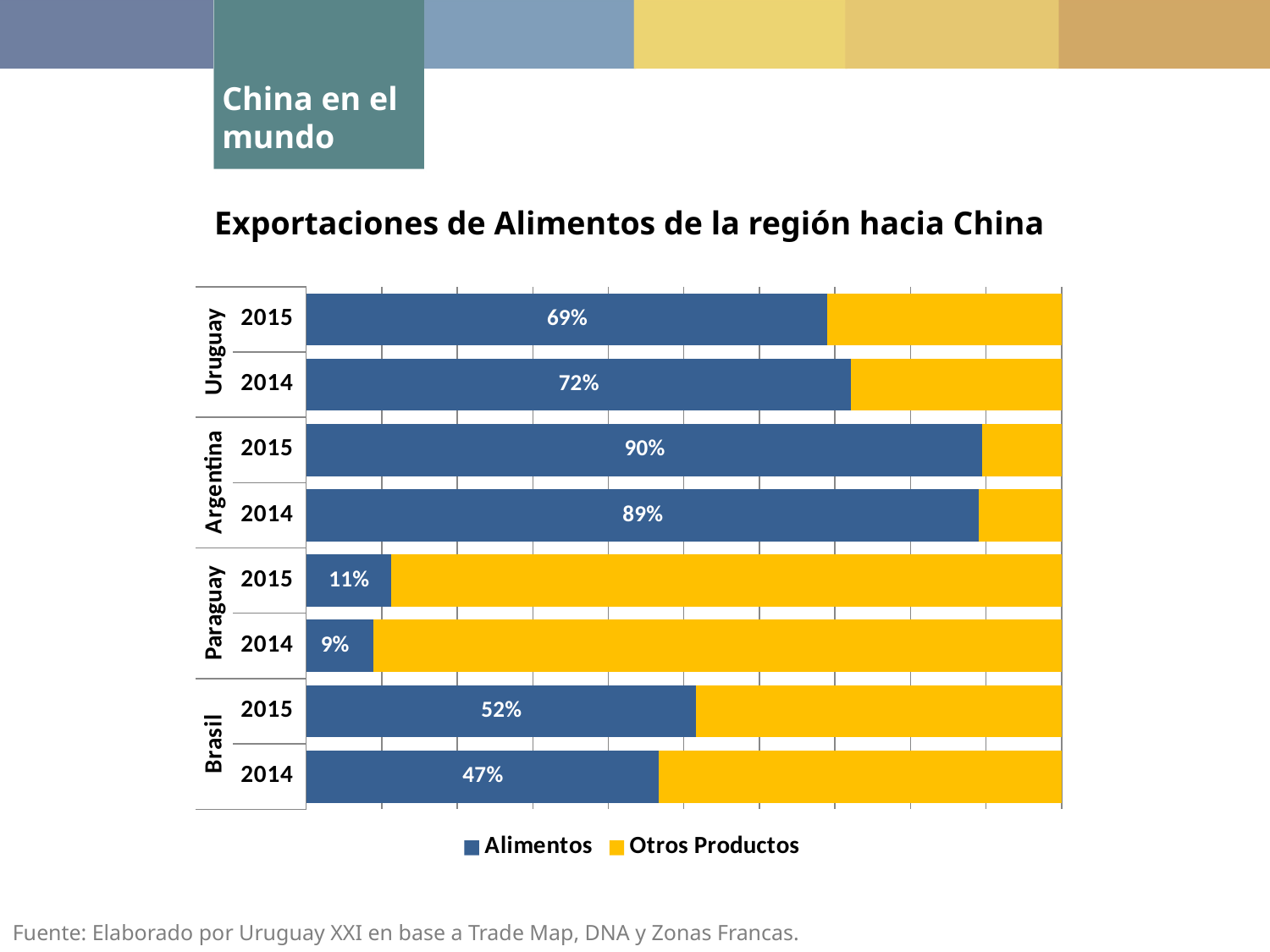
What is the Alimentos share for Paraguay in 2014? 9% Which country-year bar has the lowest Alimentos share? Paraguay 2014 Which is larger, the Alimentos share for Uruguay 2014 or for Brasil 2015? Uruguay 2014 Which country-year bar has the highest Alimentos share? Argentina 2015 What is the Alimentos share for Brasil in 2015? 52% What is the Alimentos share for Argentina in 2014? 89% What is the title of the chart? Exportaciones de Alimentos de la región hacia China By how many percentage points did Brasil's Alimentos share change from 2014 to 2015? 5 percentage points How many series does the legend list? 2 What is the Alimentos share for Uruguay in 2015? 69% What is the difference between Uruguay's Alimentos share in 2014 and in 2015? 3 percentage points What kind of chart is shown on the slide? Stacked bar chart